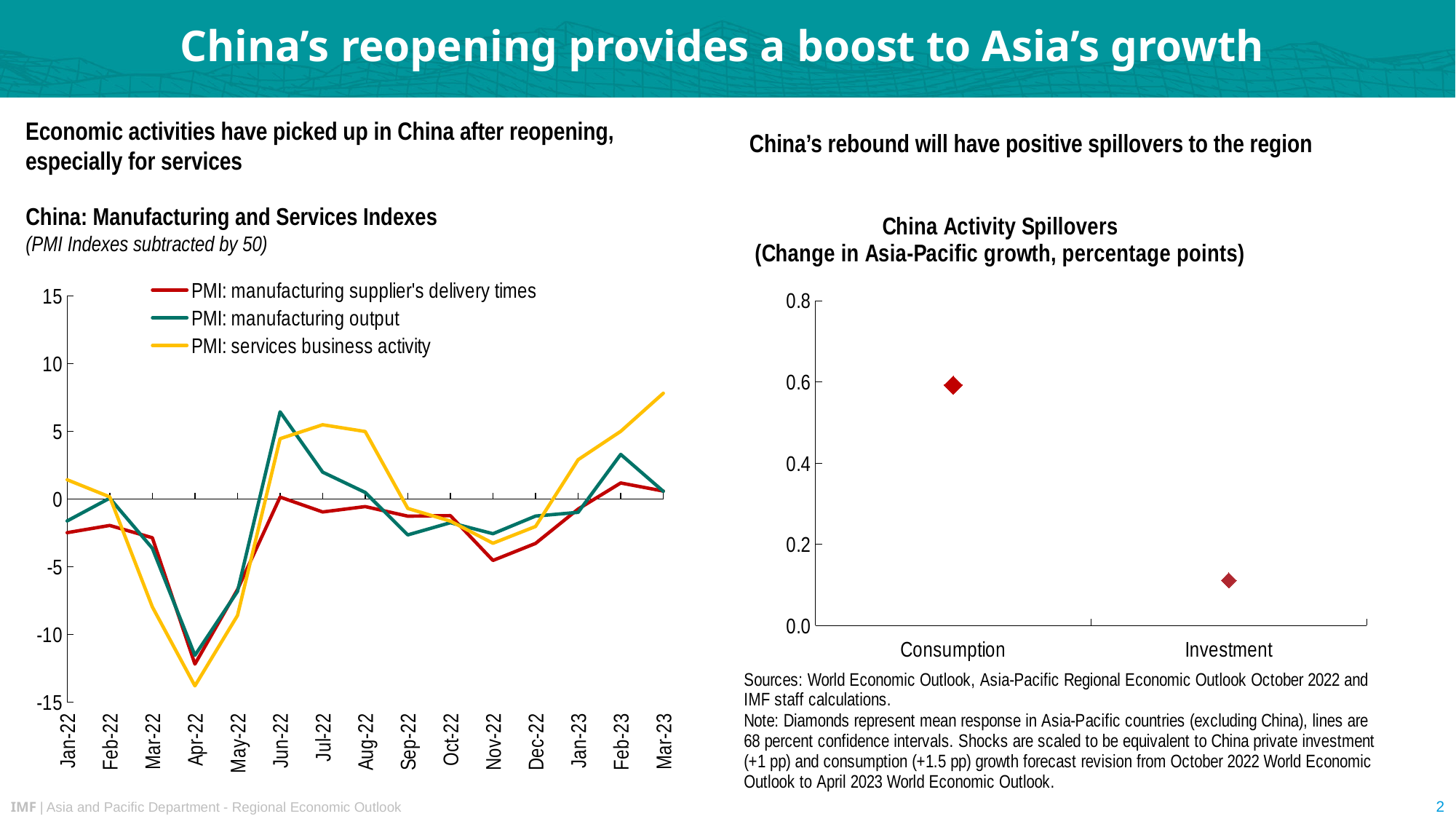
On the 'China: Manufacturing and Services Indexes' chart, how many series does the legend list? 3 On the 'China Activity Spillovers' chart, is the value for Investment greater or less than 0.2? less On the 'China Activity Spillovers' chart, is the value for Consumption greater or less than 0.4? greater On the 'China: Manufacturing and Services Indexes' chart, in which month does the PMI: services business activity series reach its lowest value? Apr-22 What kind of chart is 'China: Manufacturing and Services Indexes'? Line chart On the 'China: Manufacturing and Services Indexes' chart, is the value for PMI: services business activity in Apr-22 greater or less than -10? less On the 'China: Manufacturing and Services Indexes' chart, does the PMI: services business activity series rise or fall from Nov-22 to Mar-23? Rise On the 'China: Manufacturing and Services Indexes' chart, which series has the lower value in Apr-22: PMI: services business activity or PMI: manufacturing output? PMI: services business activity On the 'China: Manufacturing and Services Indexes' chart, in which month does the PMI: services business activity series reach its highest value? Mar-23 On the 'China Activity Spillovers' chart, which category has the higher value: Consumption or Investment? Consumption On the 'China: Manufacturing and Services Indexes' chart, how many months are shown on the x axis? 15